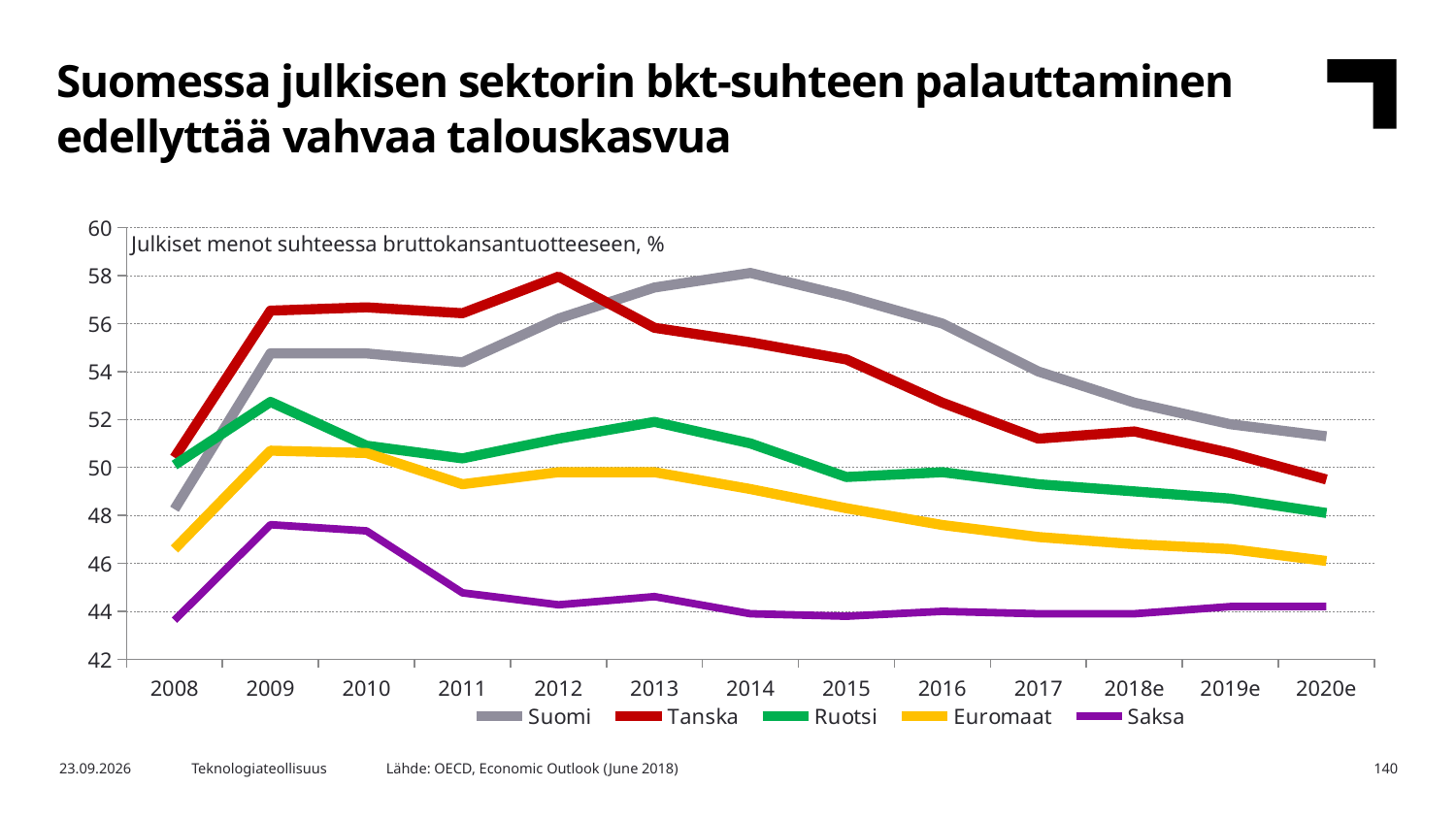
Which series has the highest value in 2014? Suomi What is the label printed inside the chart area describing the measure? Julkiset menot suhteessa bruttokansantuotteeseen, % Is the value for Saksa in 2009 greater or less than 46? greater Does the Euromaat line rise or fall from 2011 to 2020e? fall In 2012, which is higher, Tanska or Suomi? Tanska Is the value for Euromaat in 2020e greater or less than 48? less Which series has the lowest value in 2008? Saksa Which series are listed in the legend? Suomi, Tanska, Ruotsi, Euromaat, Saksa How many series does the legend list? 5 What kind of chart is shown on the slide? line chart How many years are shown on the x axis? 13 Is the value for Suomi in 2014 greater or less than 56? greater